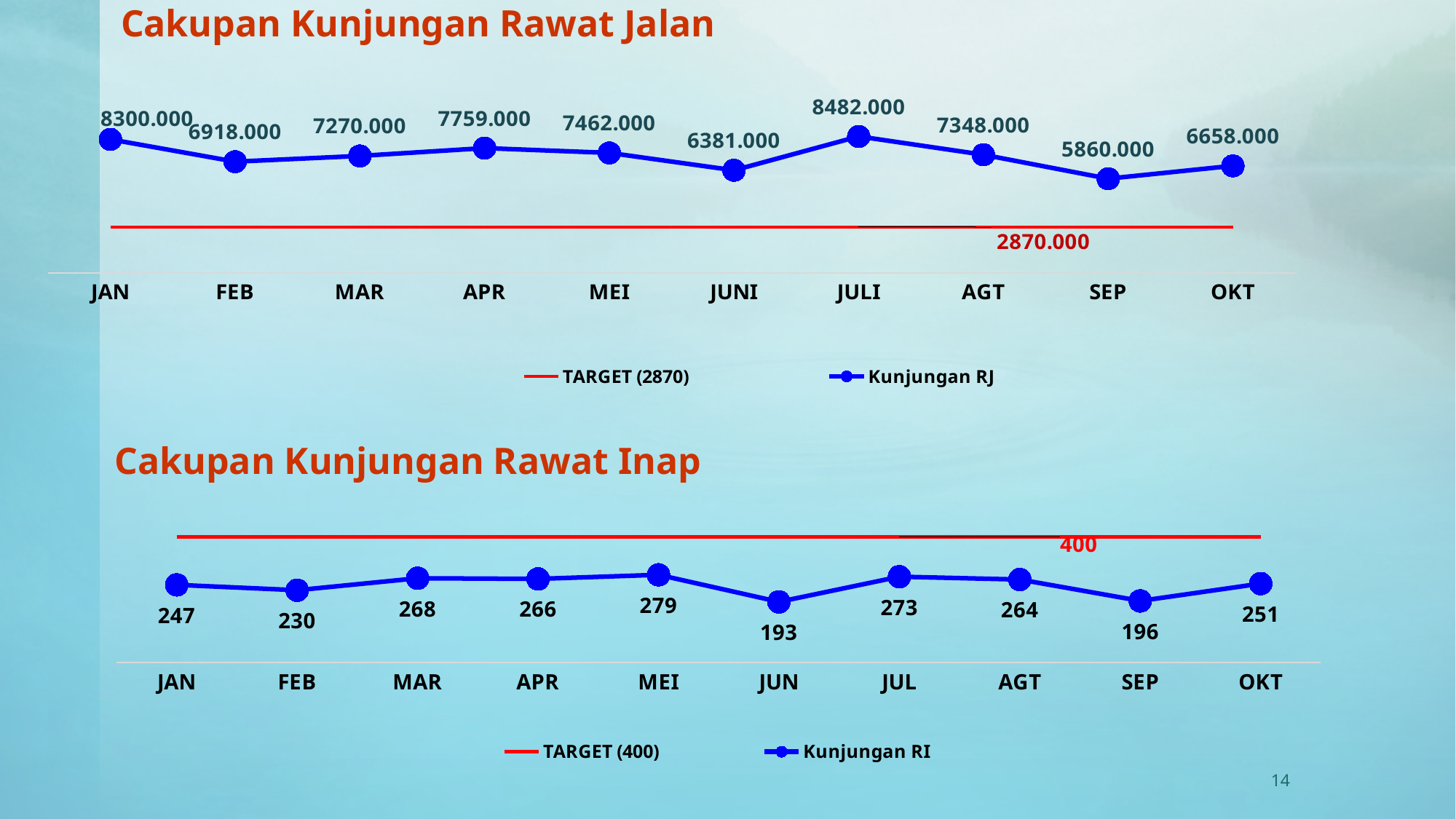
In the 'Cakupan Kunjungan Rawat Jalan' chart, what is the difference between the Kunjungan RJ values for JAN and FEB? 1382.000 In the 'Cakupan Kunjungan Rawat Jalan' chart, what value is shown for the TARGET line? 2870.000 In the 'Cakupan Kunjungan Rawat Inap' chart, which month has the lowest Kunjungan RI value? JUN In the 'Cakupan Kunjungan Rawat Jalan' chart, how many series does the legend list? 2 In the 'Cakupan Kunjungan Rawat Jalan' chart, which month has the lowest Kunjungan RJ value? SEP In the 'Cakupan Kunjungan Rawat Inap' chart, which is larger, the Kunjungan RI value for MAR or for AGT? MAR In the 'Cakupan Kunjungan Rawat Inap' chart, what is the difference between the Kunjungan RI values for MEI and JUN? 86 In the 'Cakupan Kunjungan Rawat Jalan' chart, which month has the highest Kunjungan RJ value? JULI In the 'Cakupan Kunjungan Rawat Inap' chart, how many months are plotted on the x axis? 10 What kind of chart is the 'Cakupan Kunjungan Rawat Inap' chart? Line chart In the 'Cakupan Kunjungan Rawat Jalan' chart, what is the Kunjungan RJ value for JULI? 8482.000 In the 'Cakupan Kunjungan Rawat Inap' chart, what is the Kunjungan RI value for MEI? 279